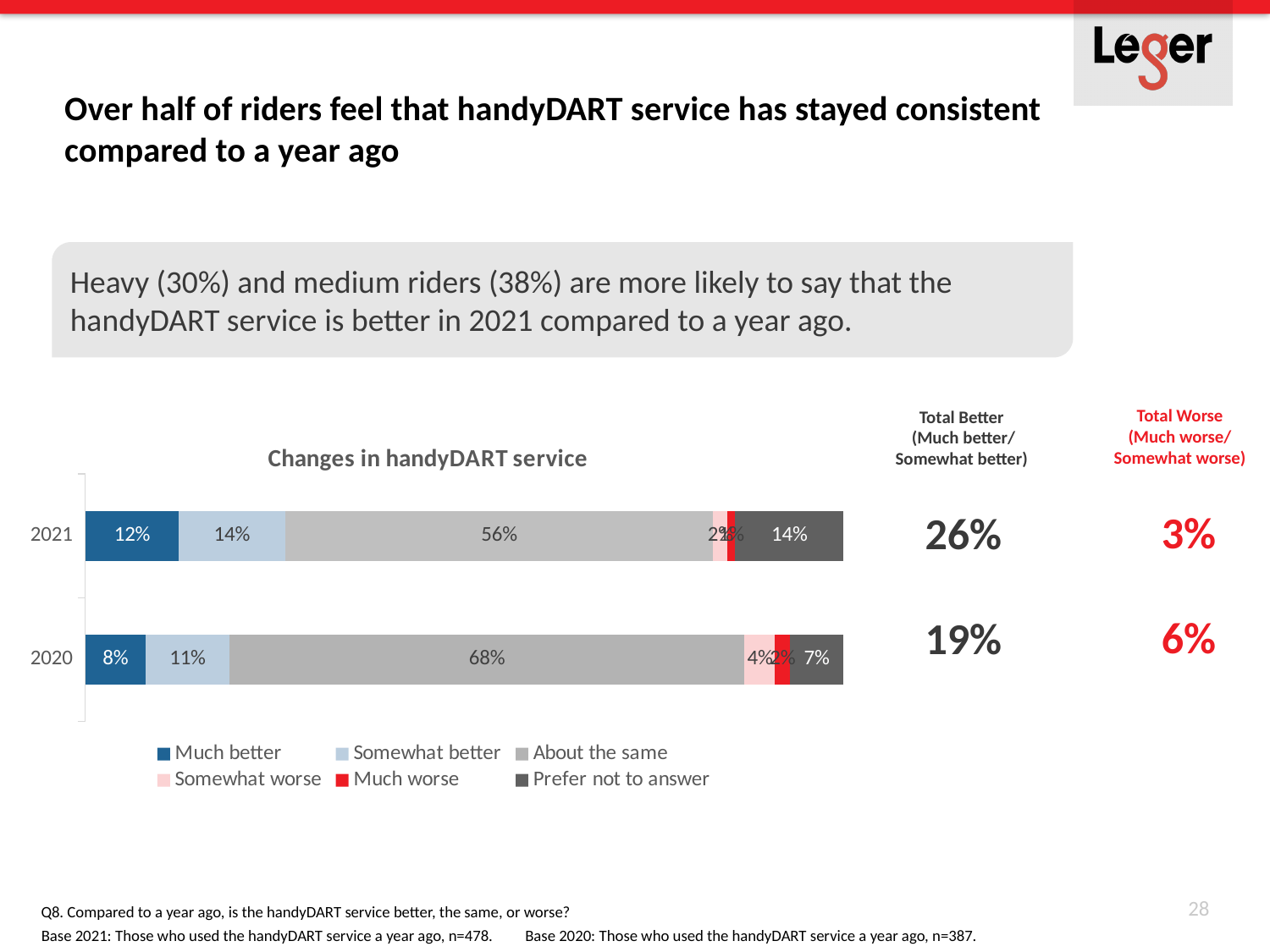
By how many percentage points did the 'About the same' share fall from 2020 to 2021? 12 percentage points Which response category is the largest segment of the 2020 bar? About the same What kind of chart is shown on the slide? Stacked bar chart How many years (categories) are plotted in the chart? 2 What percentage of riders said the service was 'About the same' in 2020? 68% Which year has the larger 'Much better' share, 2021 or 2020? 2021 What is the title of the chart? Changes in handyDART service What percentage of riders said the service was 'About the same' in 2021? 56% What is the 'Prefer not to answer' value for 2021? 14% What is the 'Somewhat better' value for 2020? 11% How many series does the chart legend list? 6 What is the 'Much better' value for 2021? 12%